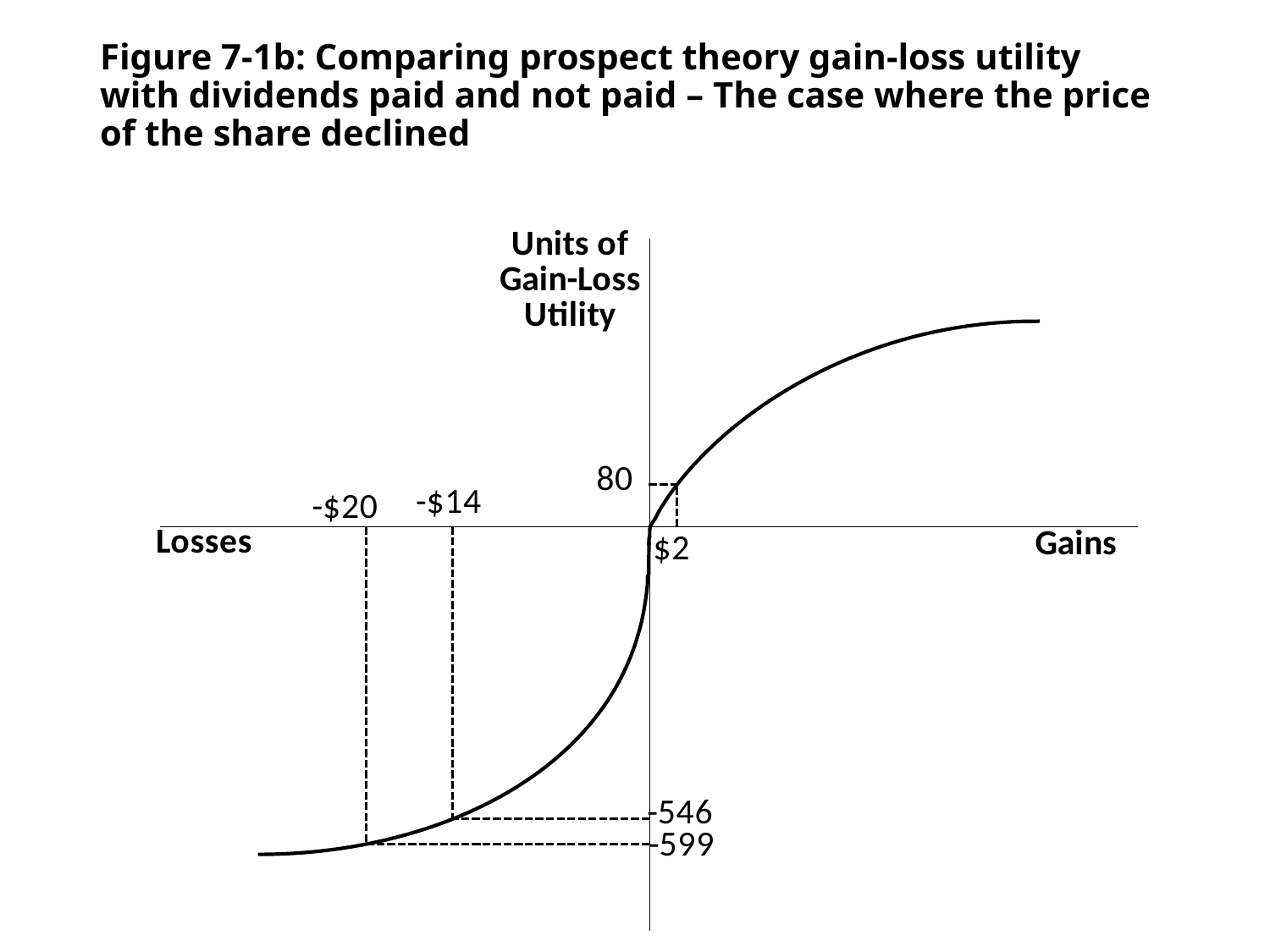
Which labeled point on the curve has the highest gain-loss utility? $2 What kind of chart is shown on the slide? Line chart Which has the larger gain-loss utility, the -$14 point or the -$20 point? -$14 How many labeled points are marked on the curve? 3 What is the gain-loss utility shown for a loss of -$14? -546 Which labeled point on the curve has the lowest gain-loss utility? -$20 Does the gain-loss utility rise or fall as you move from losses to gains along the horizontal axis? Rise What is the difference in gain-loss utility between the $2 point and the -$14 point? 626 What is the gain-loss utility shown for a loss of -$20? -599 What is the gain-loss utility shown for a gain of $2? 80 What is the label on the vertical axis of the chart? Units of Gain-Loss Utility What is the difference in gain-loss utility between the -$14 point and the -$20 point? 53